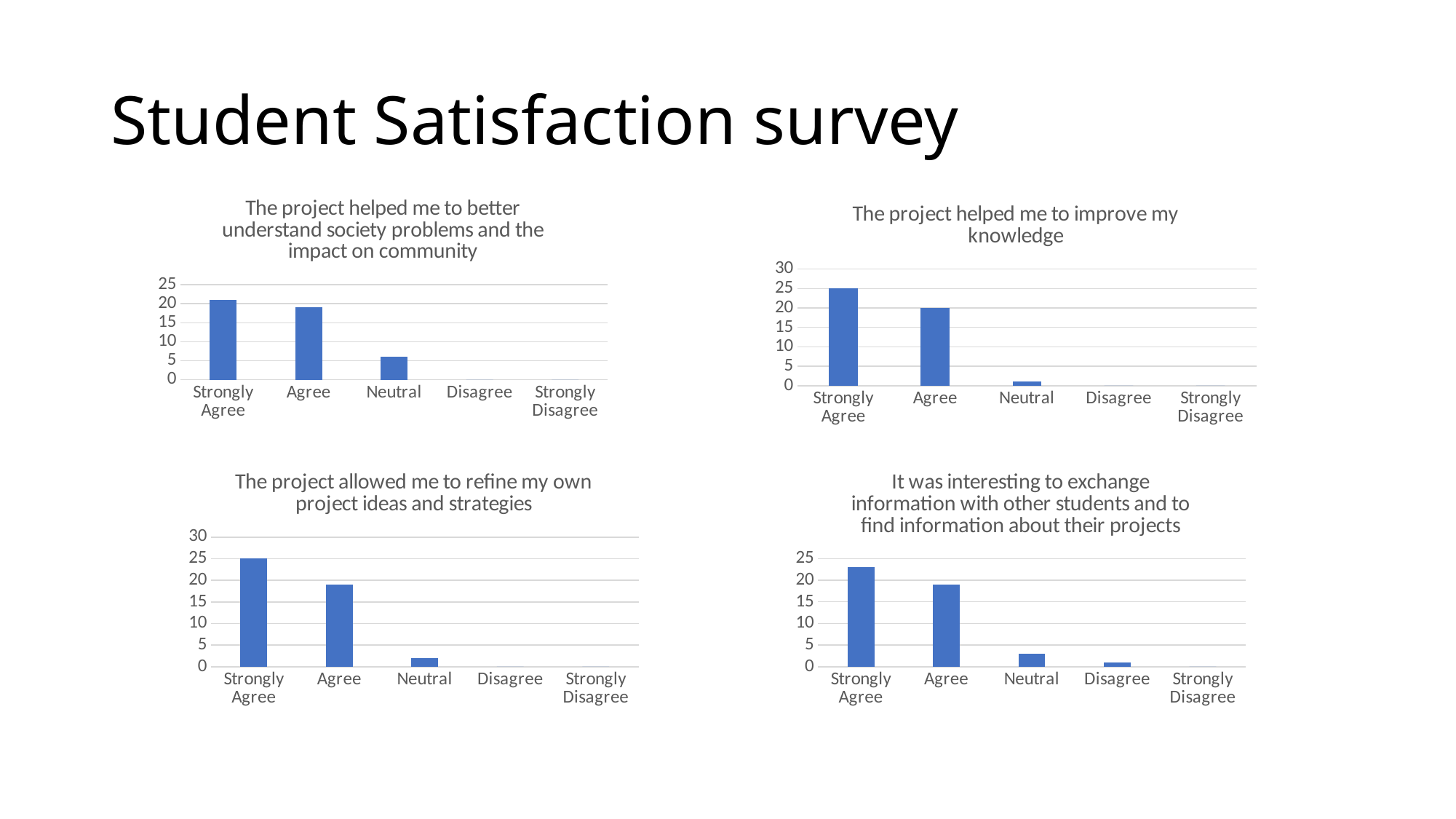
In the chart titled "The project allowed me to refine my own project ideas and strategies", which is larger, the value for Agree or the value for Neutral? Agree How many categories are shown on the x axis of the chart titled "The project helped me to improve my knowledge"? 5 In the chart titled "The project helped me to better understand society problems and the impact on community", which category has the highest value? Strongly Agree What kind of chart is the chart titled "It was interesting to exchange information with other students and to find information about their projects"? bar chart In the chart titled "The project helped me to improve my knowledge", what is the value for Agree? 20 In the chart titled "The project helped me to improve my knowledge", what is the difference between the Strongly Agree and Agree values? 5 In the chart titled "It was interesting to exchange information with other students and to find information about their projects", is the value for Strongly Agree greater or less than 20? greater In the chart titled "The project helped me to better understand society problems and the impact on community", is the value for Neutral greater or less than 10? less In the chart titled "The project allowed me to refine my own project ideas and strategies", what is the value for Strongly Agree? 25 In the chart titled "The project helped me to improve my knowledge", what is the value for Strongly Agree? 25 In the chart titled "The project allowed me to refine my own project ideas and strategies", do the values rise or fall from Strongly Agree to Strongly Disagree? fall How many charts are shown on the slide? 4